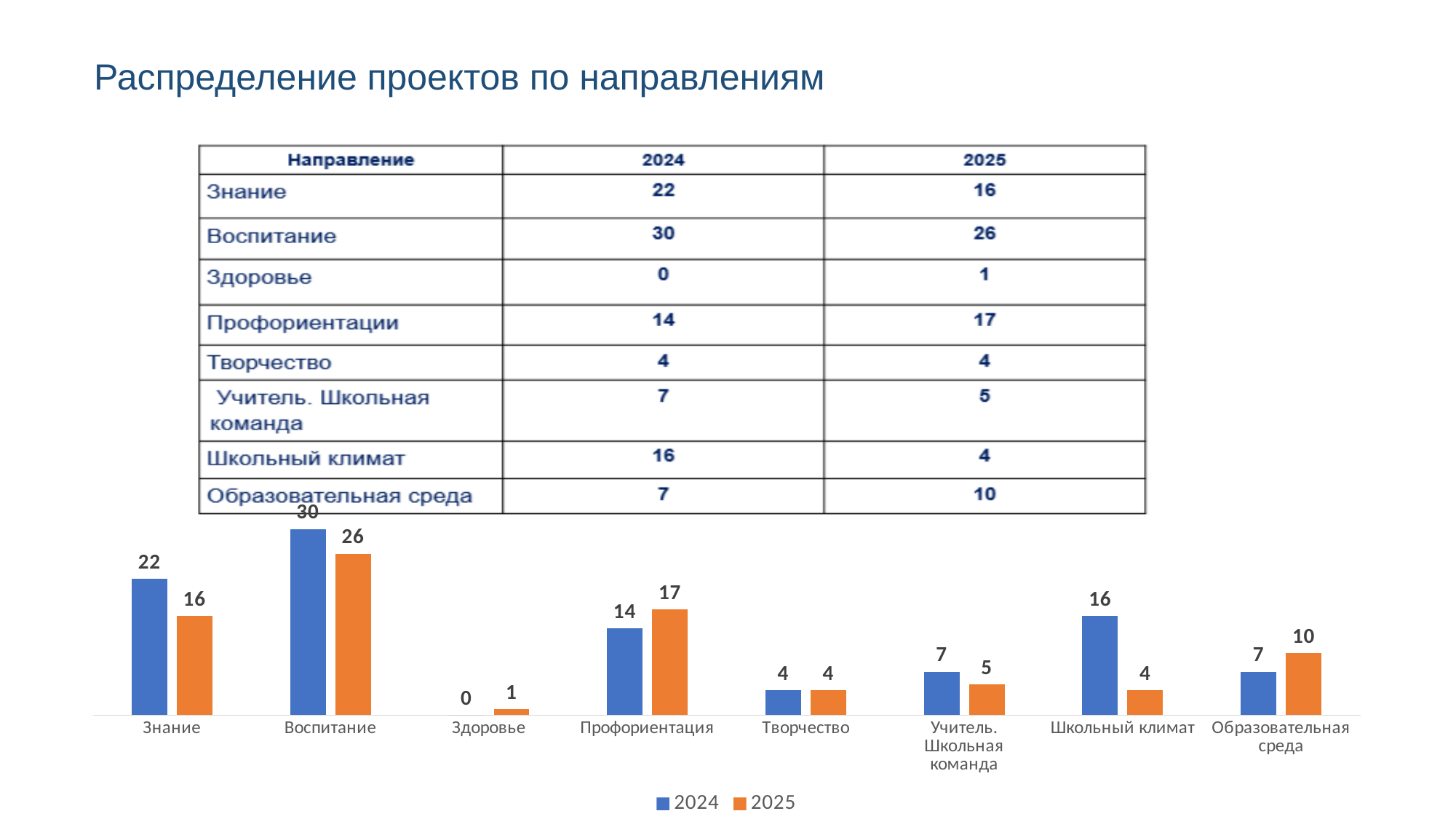
How many series does the chart legend list? 2 How many categories are shown on the x axis of the chart? 8 What is the difference between the 2024 and 2025 values for Школьный климат? 12 What kind of chart is shown on the slide? bar chart Which category has the lowest 2025 value in the chart? Здоровье Which category has the highest 2024 value in the chart? Воспитание What is the 2025 value for Школьный климат in the chart? 4 What is the 2025 value for Образовательная среда in the chart? 10 Which colour represents the 2025 series in the chart? orange Which is larger for Профориентация: the 2024 value or the 2025 value? 2025 What is the 2024 value for Воспитание in the chart? 30 What is the difference between the 2024 and 2025 values for Знание? 6